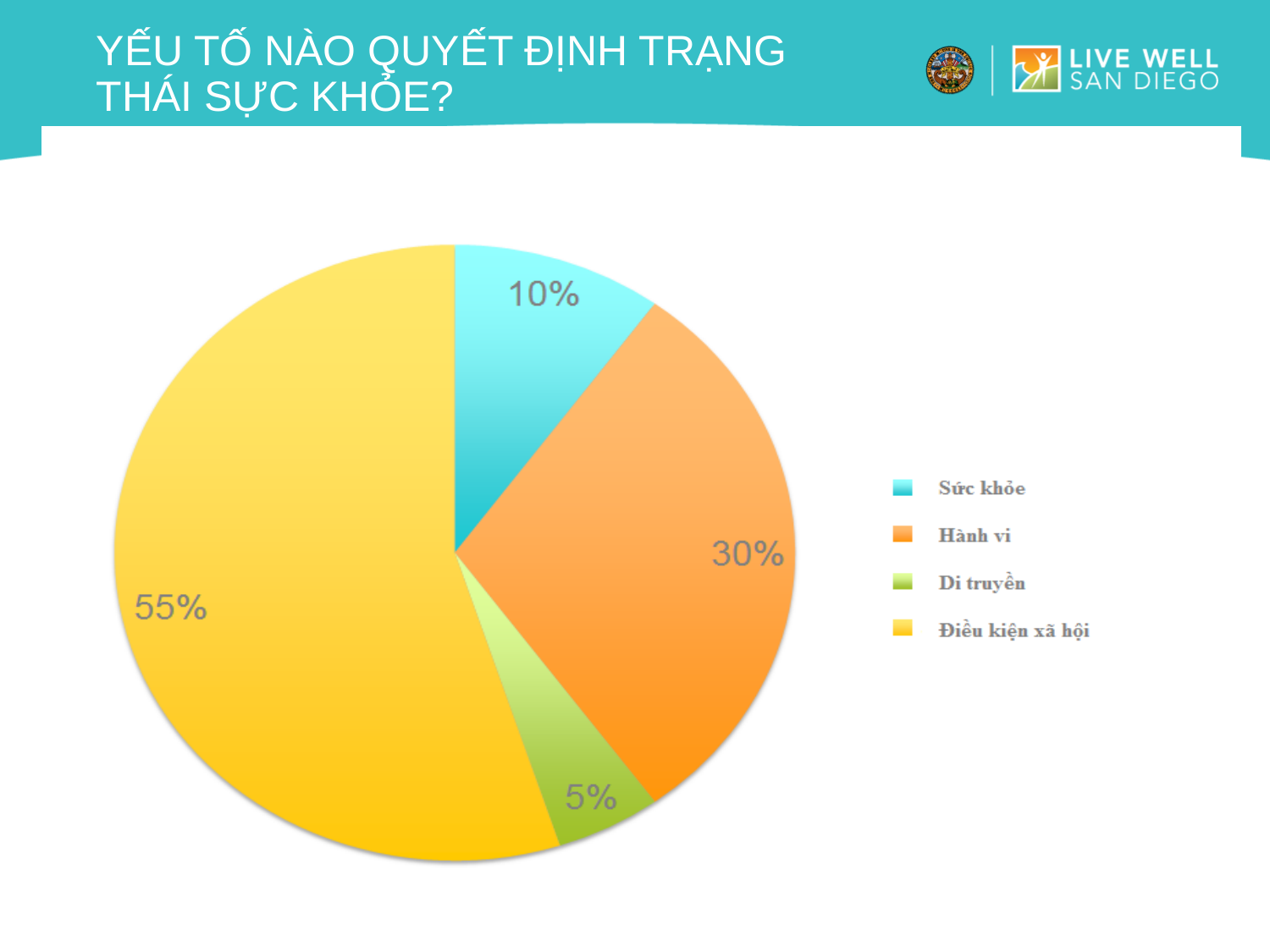
Which legend entry is shown in green? Di truyền What is the difference between the shares of Điều kiện xã hội and Hành vi? 25% Which category has the smallest slice of the pie? Di truyền What share of the pie does Sức khỏe have? 10% What share of the pie does Điều kiện xã hội have? 55% What share of the pie does Hành vi have? 30% What kind of chart is shown on the slide? Pie chart Which category has the largest slice of the pie? Điều kiện xã hội Which is larger, the share for Sức khỏe or the share for Di truyền? Sức khỏe What colour is the slice for Hành vi? Orange How many categories does the pie chart show? 4